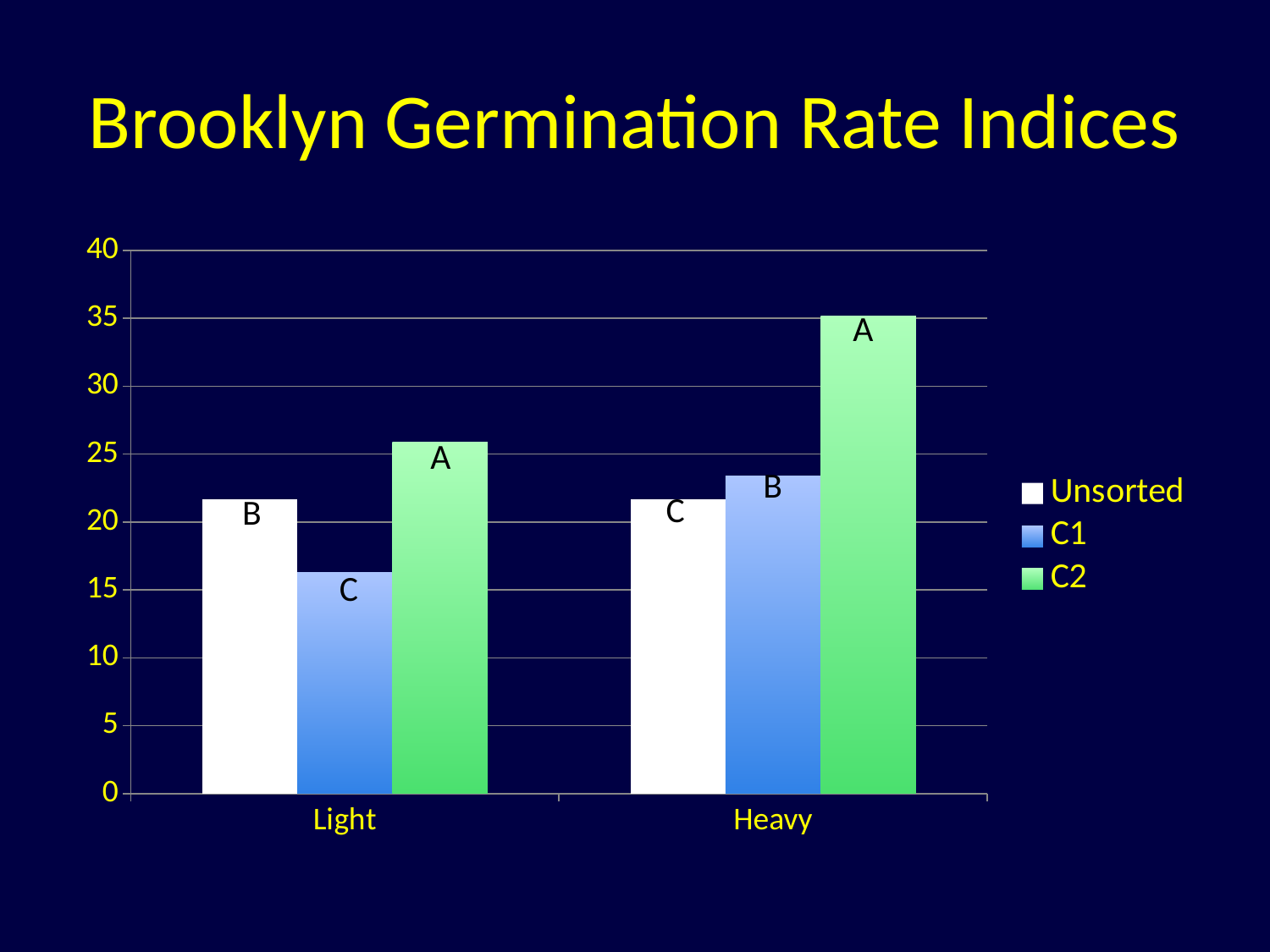
Is the C2 value for Heavy greater or less than 30? greater What letter label is printed on the C2 bar in the Heavy category? A What kind of chart is shown on the slide? bar chart Which bar is the tallest in the whole chart? C2 in Heavy Is the Unsorted value for Light greater or less than 20? greater Is the C1 value for Light greater or less than 20? less Which series has the lowest bar in the Light category? C1 What is the title of the chart? Brooklyn Germination Rate Indices How many categories are shown on the x axis? 2 Which series has the highest bar in the Heavy category? C2 Which is larger, the C2 value for Light or the C2 value for Heavy? Heavy How many series does the legend list? 3